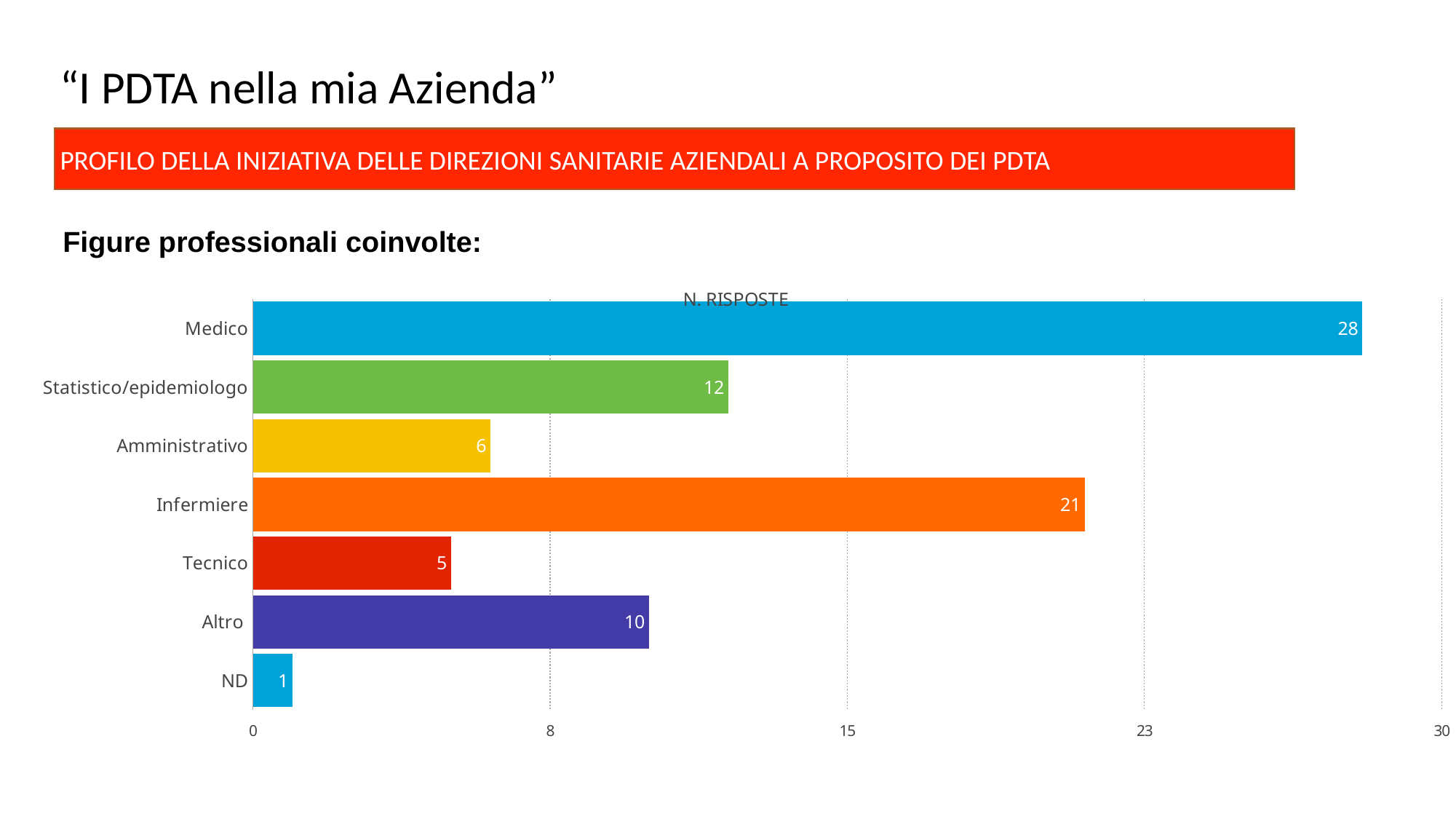
What is the title of the chart? N. RISPOSTE What is the value for Statistico/epidemiologo? 12 What is the difference between the values for Medico and Infermiere? 7 What is the difference between the values for Altro and Tecnico? 5 Which category has the highest value? Medico How many categories are shown in the chart? 7 What kind of chart is shown on the slide? Bar chart What is the value for ND? 1 What is the value for Infermiere? 21 Which is larger, the value for Amministrativo or the value for Altro? Altro What is the value for Medico? 28 Which category has the lowest value? ND